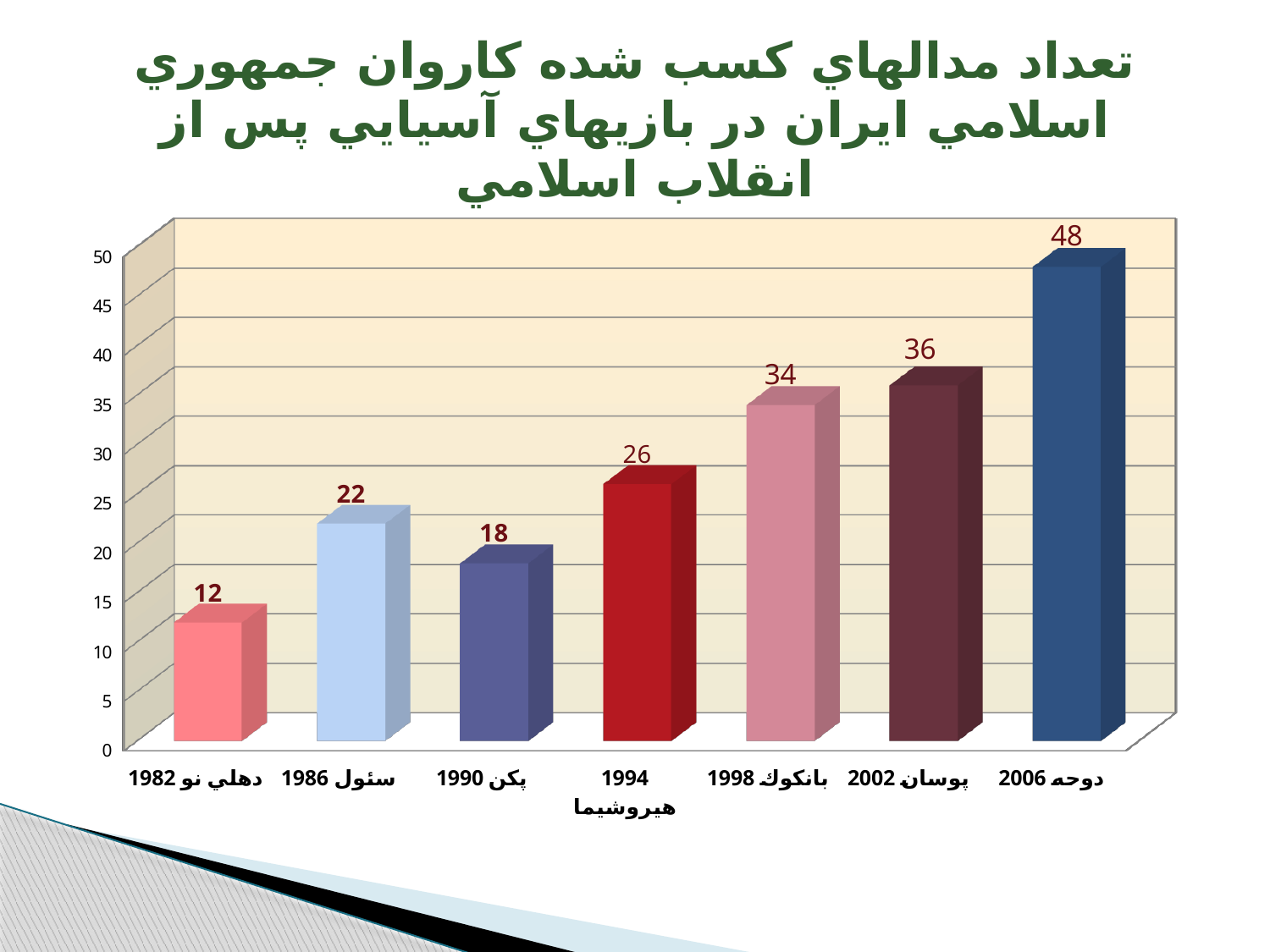
What is the difference between the values for 1990 (پكن) and 1982 (دهلي نو)? 6 What is the difference between the values for 2006 (دوحه) and 1998 (بانكوك)? 14 What value is shown for 1994 (هيروشيما)? 26 What value is shown for 2002 (پوسان)? 36 Is the value for 1998 (بانكوك) greater or less than 30? greater Do the values generally rise or fall from 1982 to 2006? rise How many categories are shown on the x axis? 7 Which category has the lowest value? 1982 دهلي نو What value is shown for 1982 (دهلي نو)? 12 What kind of chart is shown on the slide? bar chart Which is larger, the value for 1986 (سئول) or the value for 1990 (پكن)? 1986 سئول Which category has the highest value? 2006 دوحه